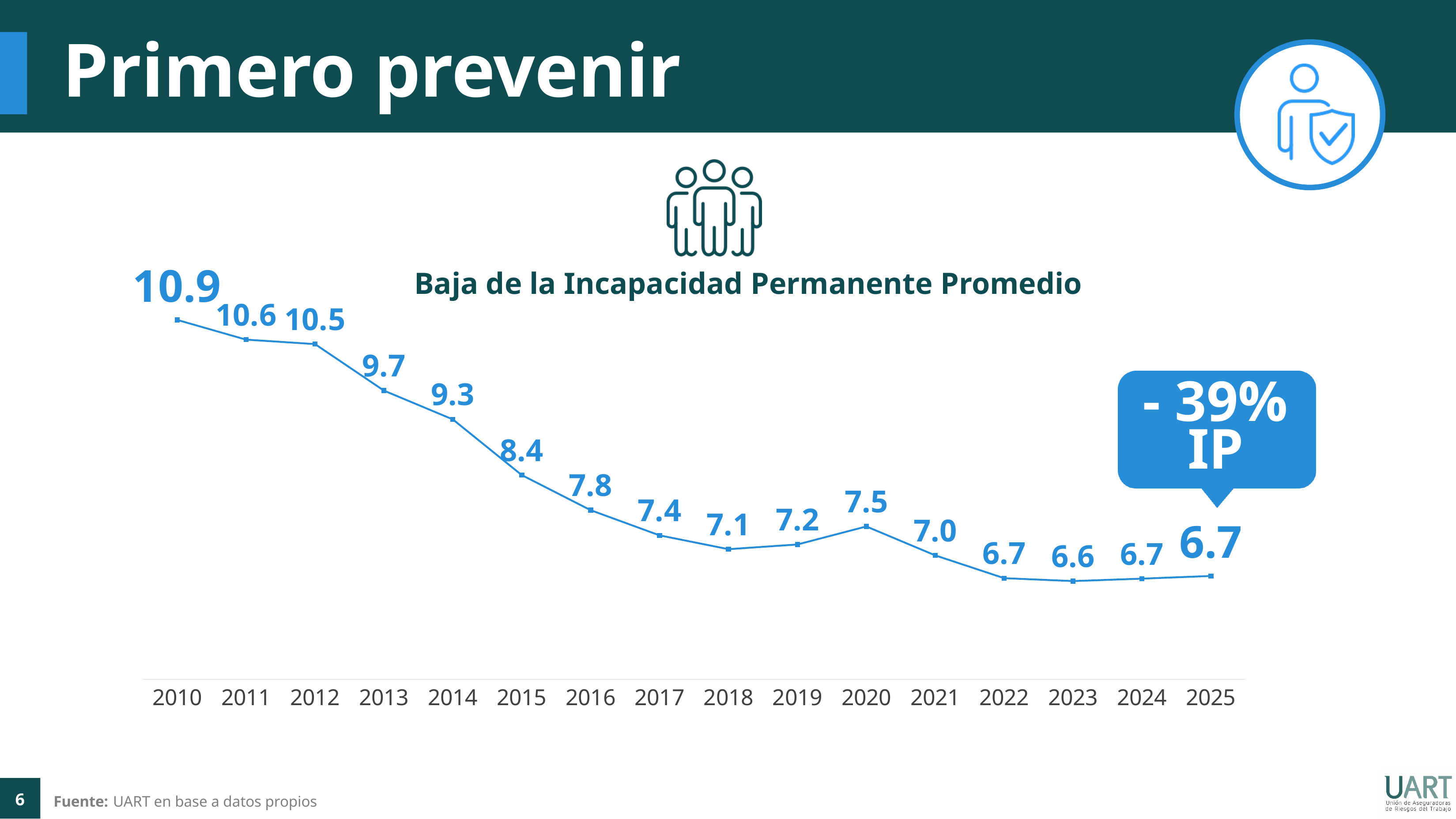
Which year has the highest value? 2010 Do the values generally rise or fall from 2010 to 2025? Fall Which is larger, the value for 2019 or the value for 2020? 2020 What is the value for 2020? 7.5 How many years are plotted on the chart? 16 Which year has the lowest value? 2023 What is the value for 2015? 8.4 What is the title of the chart? Baja de la Incapacidad Permanente Promedio What is the value for 2025? 6.7 What is the difference between the values for 2010 and 2025? 4.2 What kind of chart is shown? Line chart What is the value for 2010? 10.9